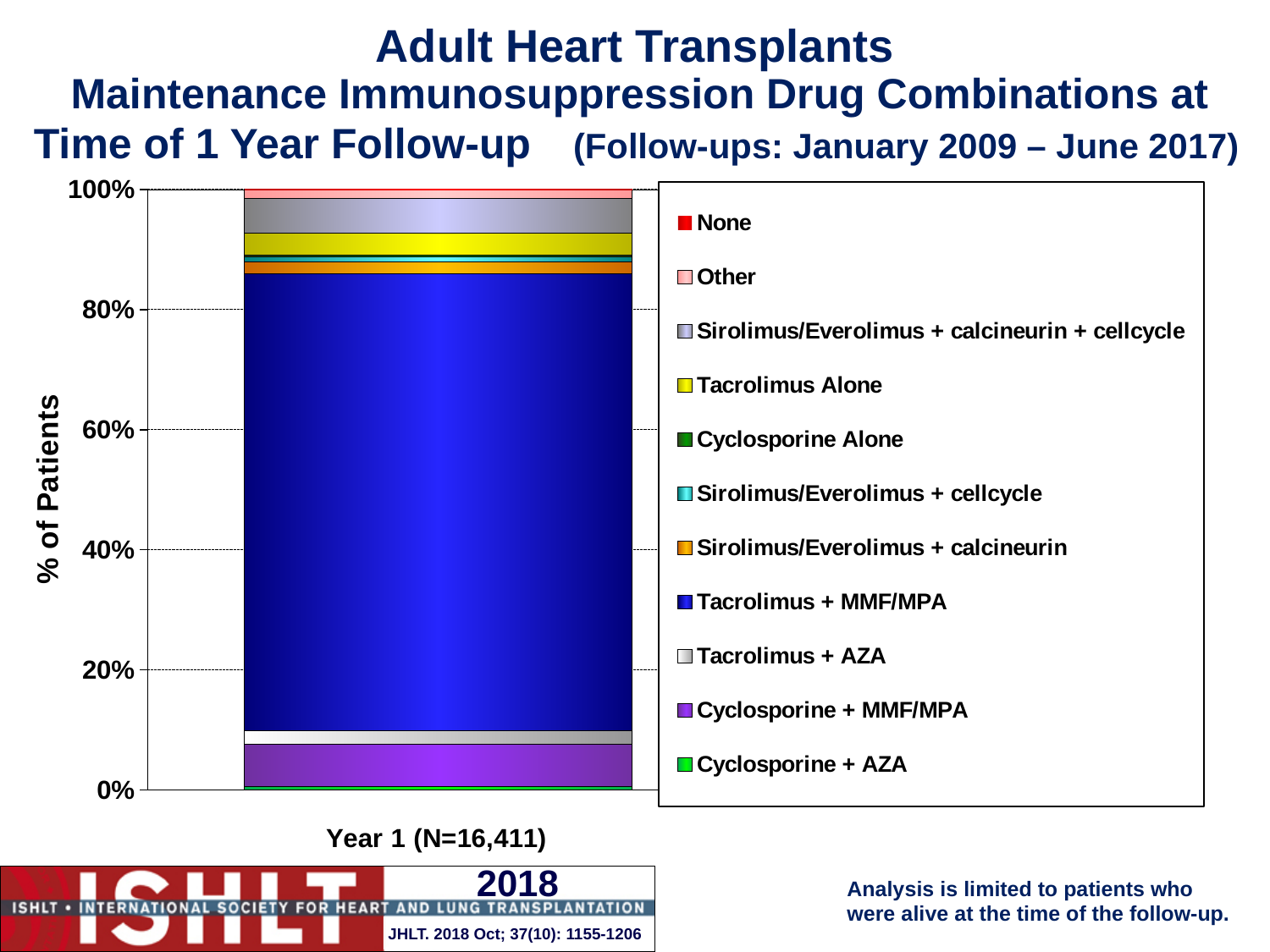
Which segment is larger: Tacrolimus Alone or Cyclosporine Alone? Tacrolimus Alone Is the share for Tacrolimus + MMF/MPA greater or less than 60%? greater What is the y-axis label of the chart? % of Patients What value does the top of the stacked bar reach on the y axis? 100% Which segment is larger: Cyclosporine + MMF/MPA or Tacrolimus + AZA? Cyclosporine + MMF/MPA What is the label of the single category on the x axis? Year 1 (N=16,411) How many bars (categories) are plotted on the x axis? 1 What kind of chart is shown on the slide? Stacked bar chart How many series does the legend list? 11 Is the share for Cyclosporine + MMF/MPA greater or less than 20%? less Which legend entry is listed first? None Which drug combination makes up the largest segment of the Year 1 bar? Tacrolimus + MMF/MPA